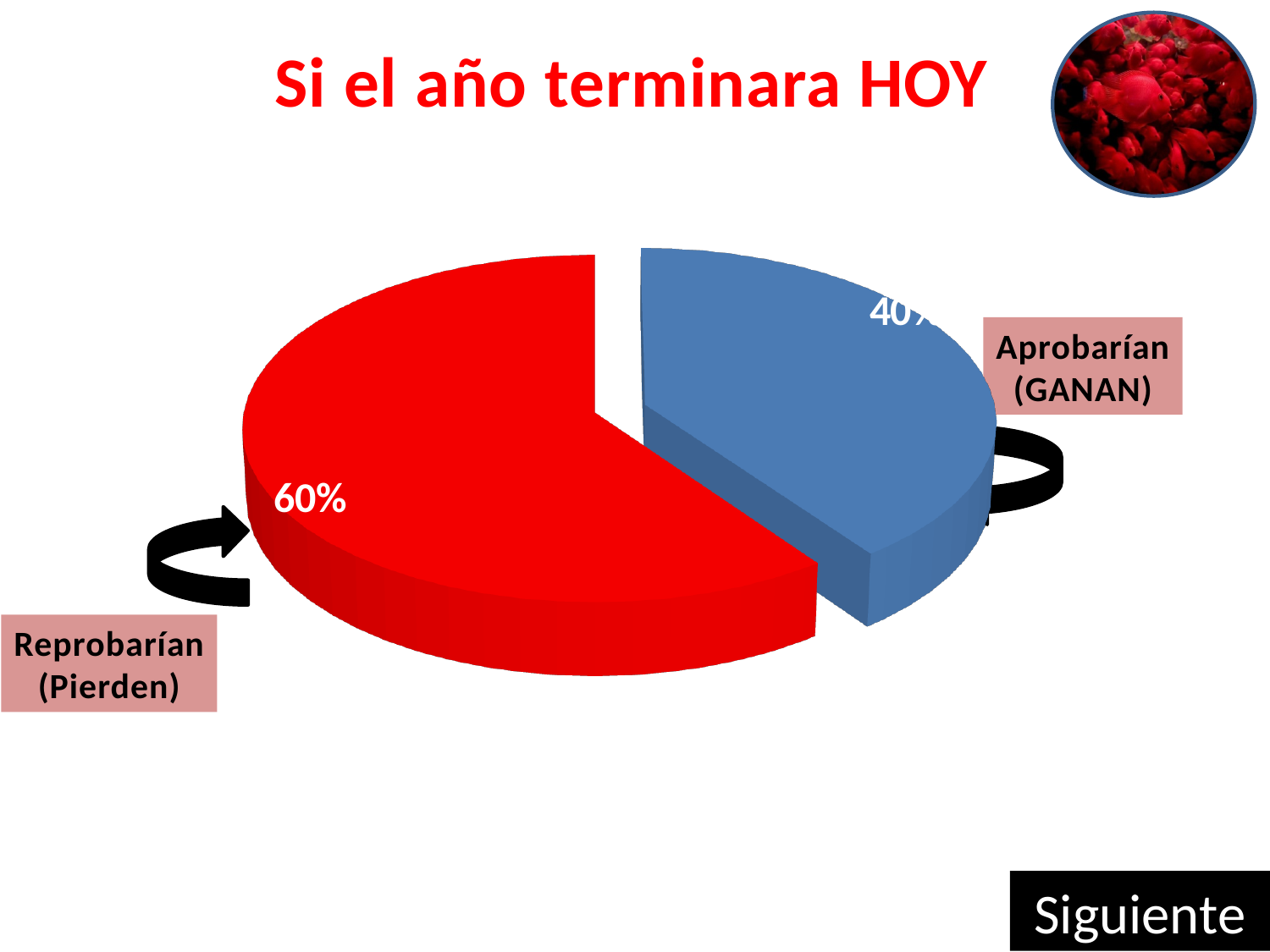
Which slice is the largest in the pie chart? Reprobarían (Pierden) What is the title of the slide containing the pie chart? Si el año terminara HOY What kind of chart is shown on the slide? pie chart Which slice is the smallest in the pie chart? Aprobarían (GANAN) What share of the pie does the "Aprobarían (GANAN)" slice represent? 40% What is the difference in percentage points between the "Reprobarían (Pierden)" slice and the "Aprobarían (GANAN)" slice? 20% What colour is the "Aprobarían (GANAN)" slice? blue What share of the pie does the "Reprobarían (Pierden)" slice represent? 60% How many slices does the pie chart have? 2 Which is larger, the "Reprobarían (Pierden)" slice or the "Aprobarían (GANAN)" slice? Reprobarían (Pierden)